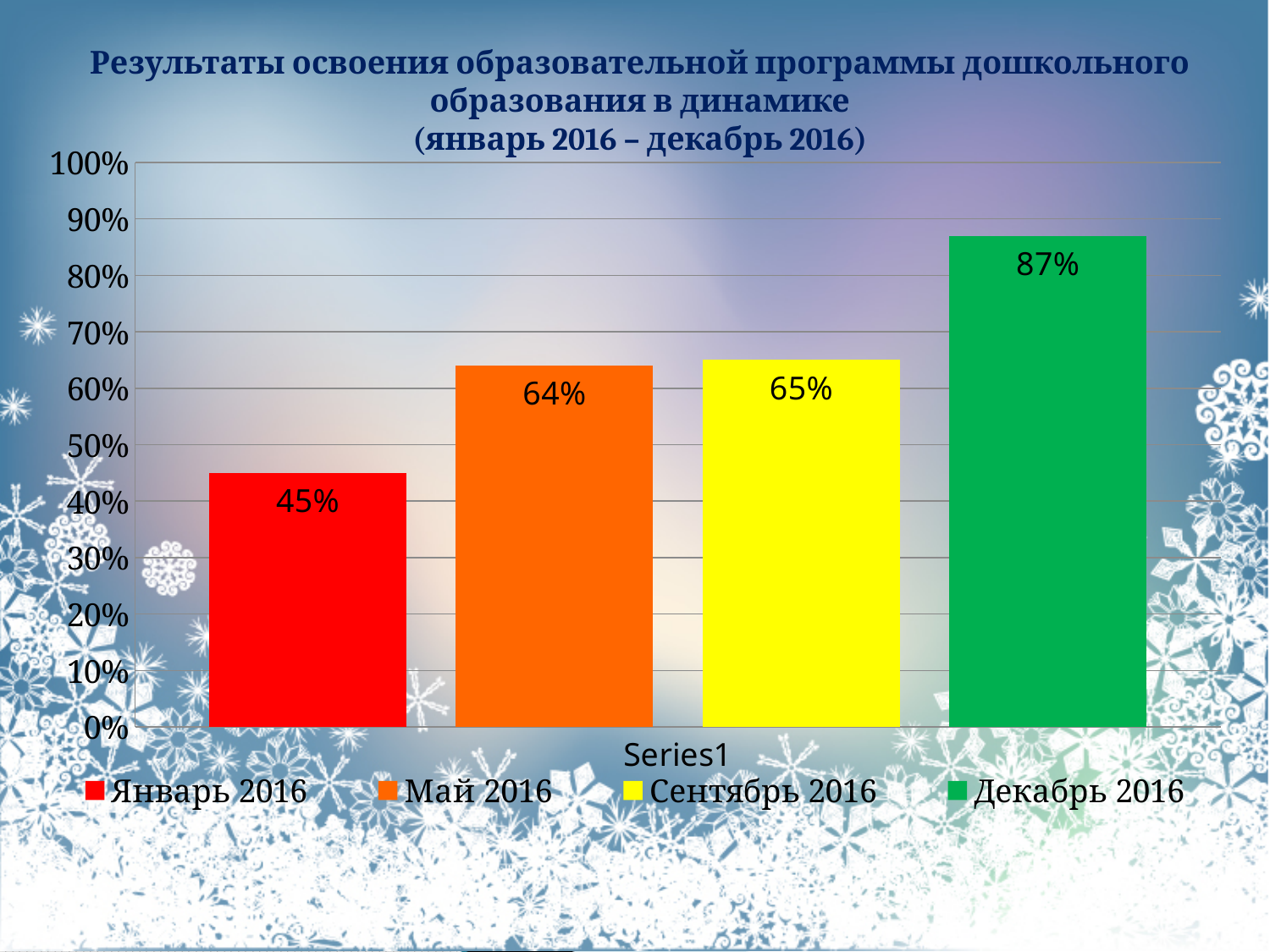
Which period has the highest value? Декабрь 2016 What is the value for Декабрь 2016? 87% What is the value for Май 2016? 64% What kind of chart is shown on the slide? Bar chart Do the values rise or fall from Январь 2016 to Декабрь 2016? Rise What is the difference between the values for Декабрь 2016 and Январь 2016? 42% What is the difference between the values for Май 2016 and Январь 2016? 19% Which is larger, the value for Декабрь 2016 or the value for Май 2016? Декабрь 2016 What is the value for Сентябрь 2016? 65% What is the value for Январь 2016? 45% How many bars are shown in the chart? 4 Which period has the lowest value? Январь 2016